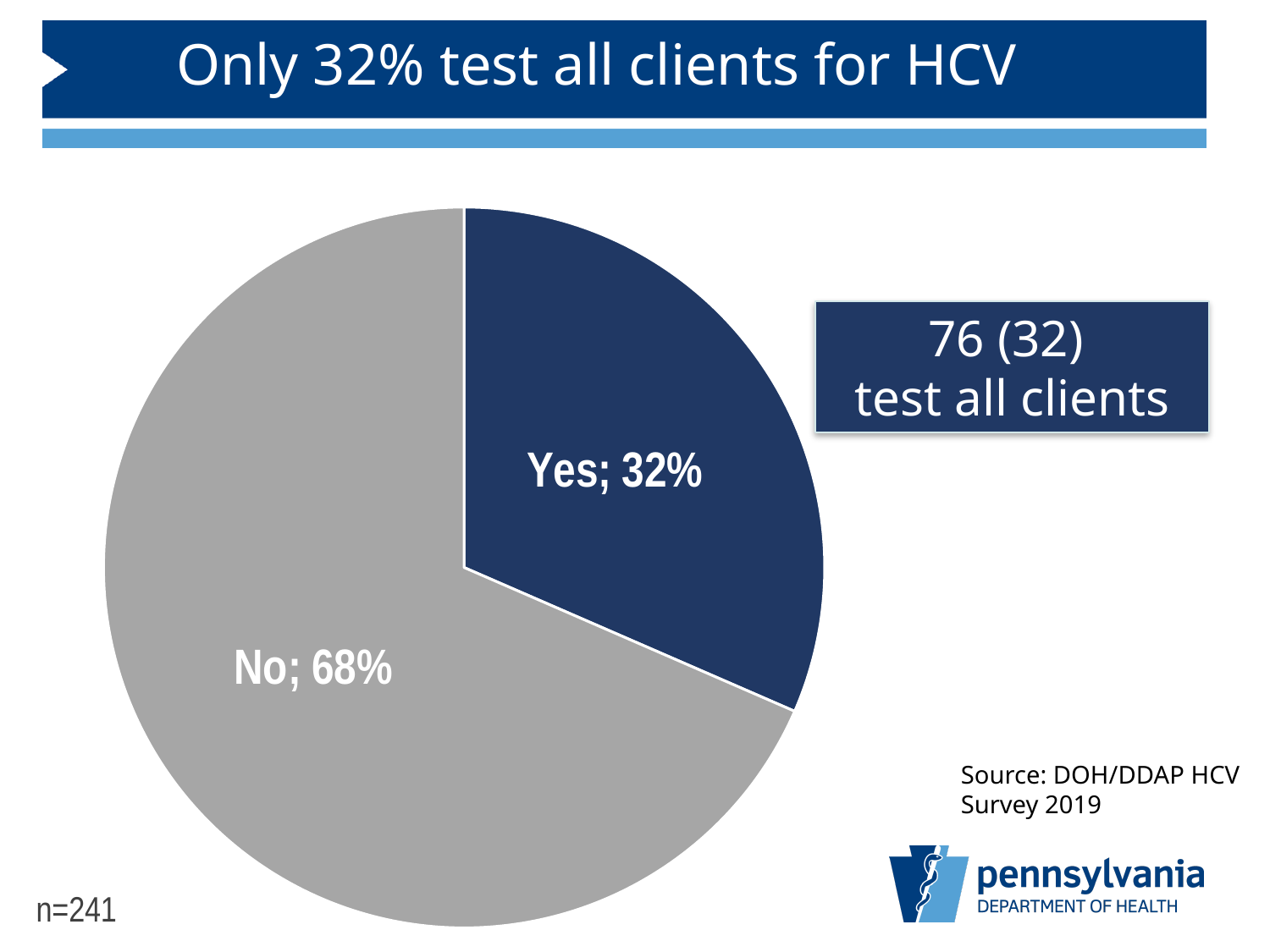
What percentage of the pie is labelled "No"? 68% What is the sample size (n) shown on the slide? n=241 Which slice of the pie is the largest? No What is the difference in percentage points between the "No" slice and the "Yes" slice? 36 What percentage of the pie is labelled "Yes"? 32% How many slices does the pie chart have? 2 Which slice of the pie is the smallest? Yes What share of the pie does the "Yes" slice represent? 32% What colour is the "Yes" slice of the pie? dark blue What kind of chart is shown on the slide? pie chart Which slice is larger, "Yes" or "No"? No